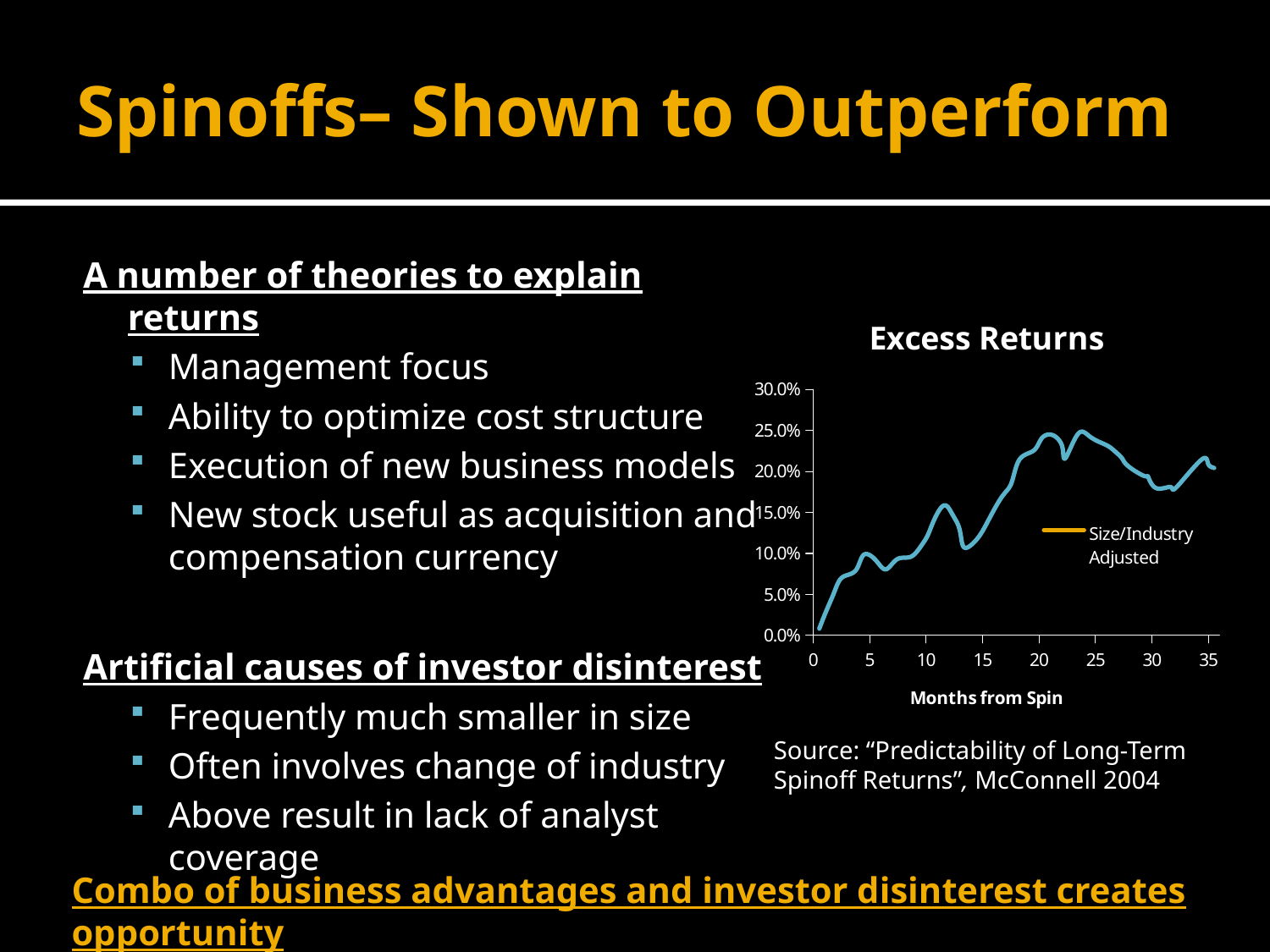
In the Excess Returns chart, is the value at 20 months from spin greater or less than 20.0%? greater In the Excess Returns chart, does the Size/Industry Adjusted line overall rise or fall from 0 to 35 months from spin? rise What is the name of the series shown in the legend of the Excess Returns chart? Size/Industry Adjusted In the Excess Returns chart, does the Size/Industry Adjusted line rise or fall between 25 and 30 months from spin? fall In the Excess Returns chart, is the value at 30 months from spin greater or less than 20.0%? less What kind of chart is shown under the title "Excess Returns"? line chart What is the title of the chart on the slide? Excess Returns In the Excess Returns chart, is the highest value of the Size/Industry Adjusted line greater or less than 30.0%? less How many series does the legend of the Excess Returns chart list? 1 In the Excess Returns chart, which is larger: the value at 20 months from spin or the value at 5 months from spin? 20 months from spin